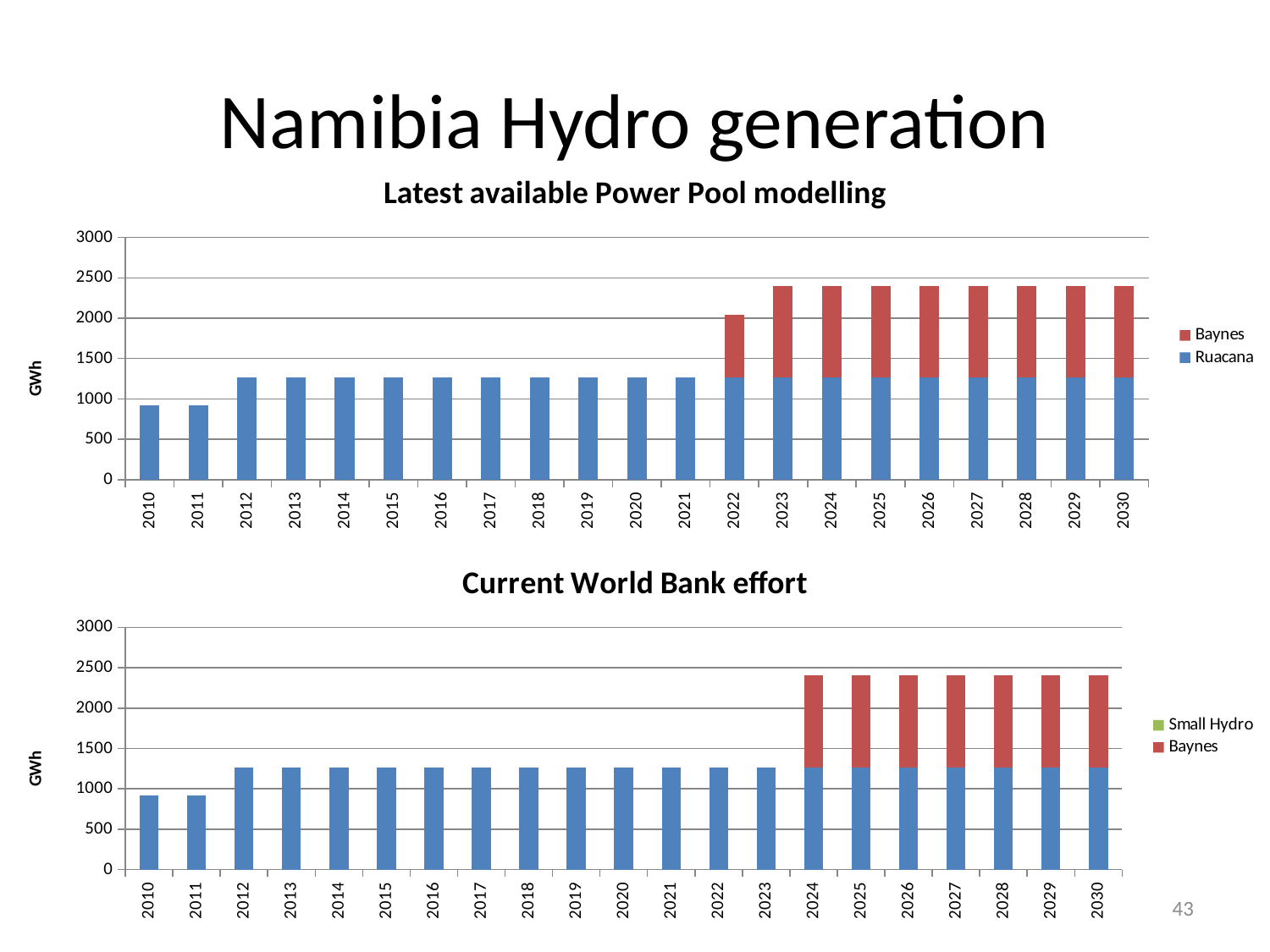
How many years are shown on the x axis of the 'Latest available Power Pool modelling' chart? 21 How many series does the legend of the 'Latest available Power Pool modelling' chart list? 2 In the 'Latest available Power Pool modelling' chart, is the value for 2010 greater or less than 1000? less What kind of chart is the 'Latest available Power Pool modelling' chart? bar chart How many series does the legend of the 'Current World Bank effort' chart list? 2 In the 'Current World Bank effort' chart, is the value for 2012 greater or less than 1500? less In the 'Latest available Power Pool modelling' chart, which year has the larger total, 2022 or 2023? 2023 In the 'Latest available Power Pool modelling' chart, do the total values rise or fall from 2010 to 2030? rise How many years are shown on the x axis of the 'Current World Bank effort' chart? 21 In the 'Latest available Power Pool modelling' chart, is the total for 2025 greater or less than 2000? greater In the 'Current World Bank effort' chart, which is the first year in which Baynes appears? 2024 In the 'Latest available Power Pool modelling' chart, which is the first year in which Baynes appears? 2022